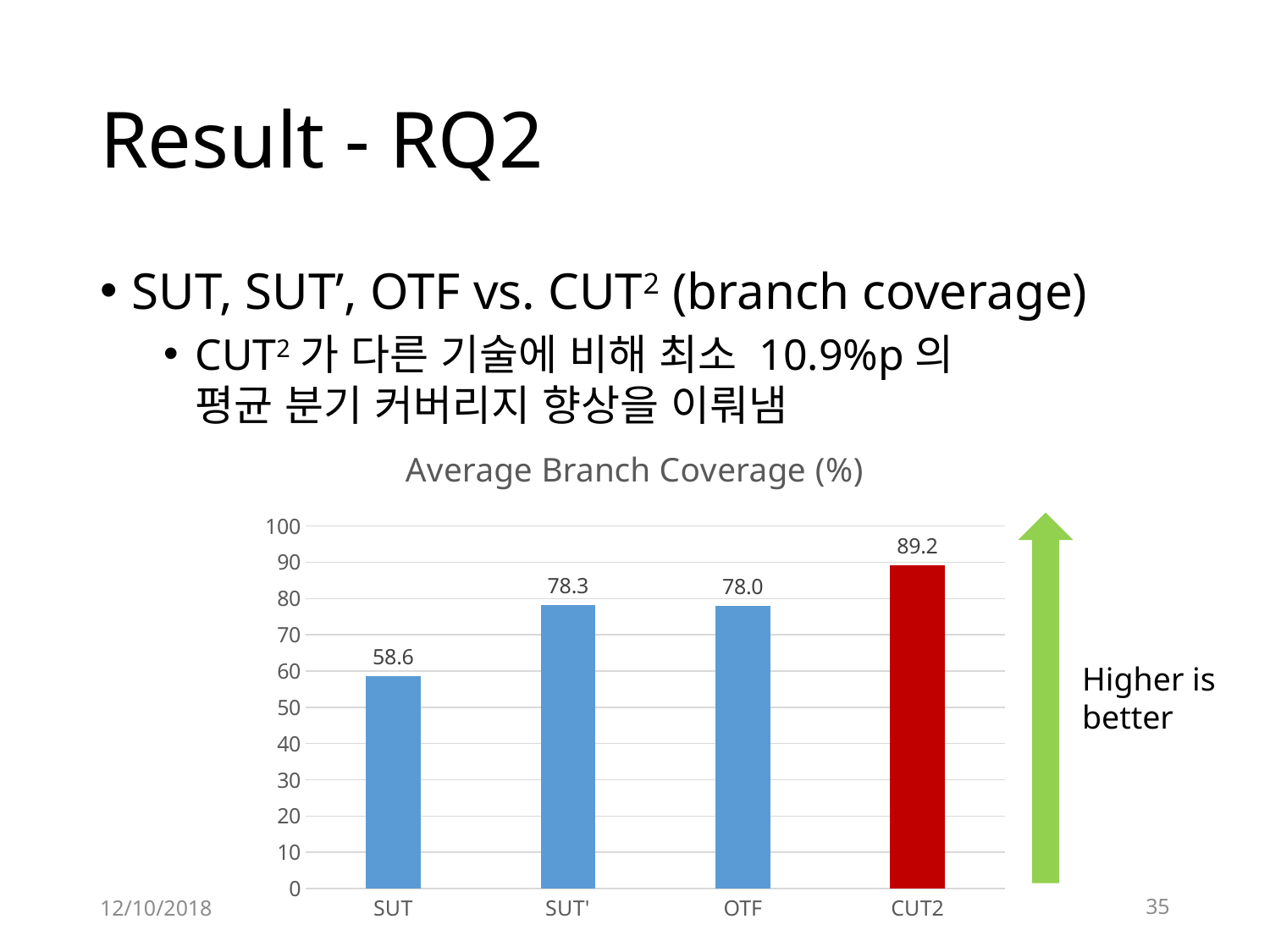
Which has a higher average branch coverage, SUT or OTF? OTF Which category has the lowest average branch coverage? SUT What is the title of the chart? Average Branch Coverage (%) What is the average branch coverage for CUT2? 89.2 What kind of chart is shown on the slide? bar chart What is the average branch coverage for SUT? 58.6 What is the difference in average branch coverage between CUT2 and SUT'? 10.9 What is the average branch coverage for OTF? 78.0 Is the value for SUT greater or less than 60? less Which category has the highest average branch coverage? CUT2 What is the difference in average branch coverage between SUT' and SUT? 19.7 How many categories are shown in the chart? 4